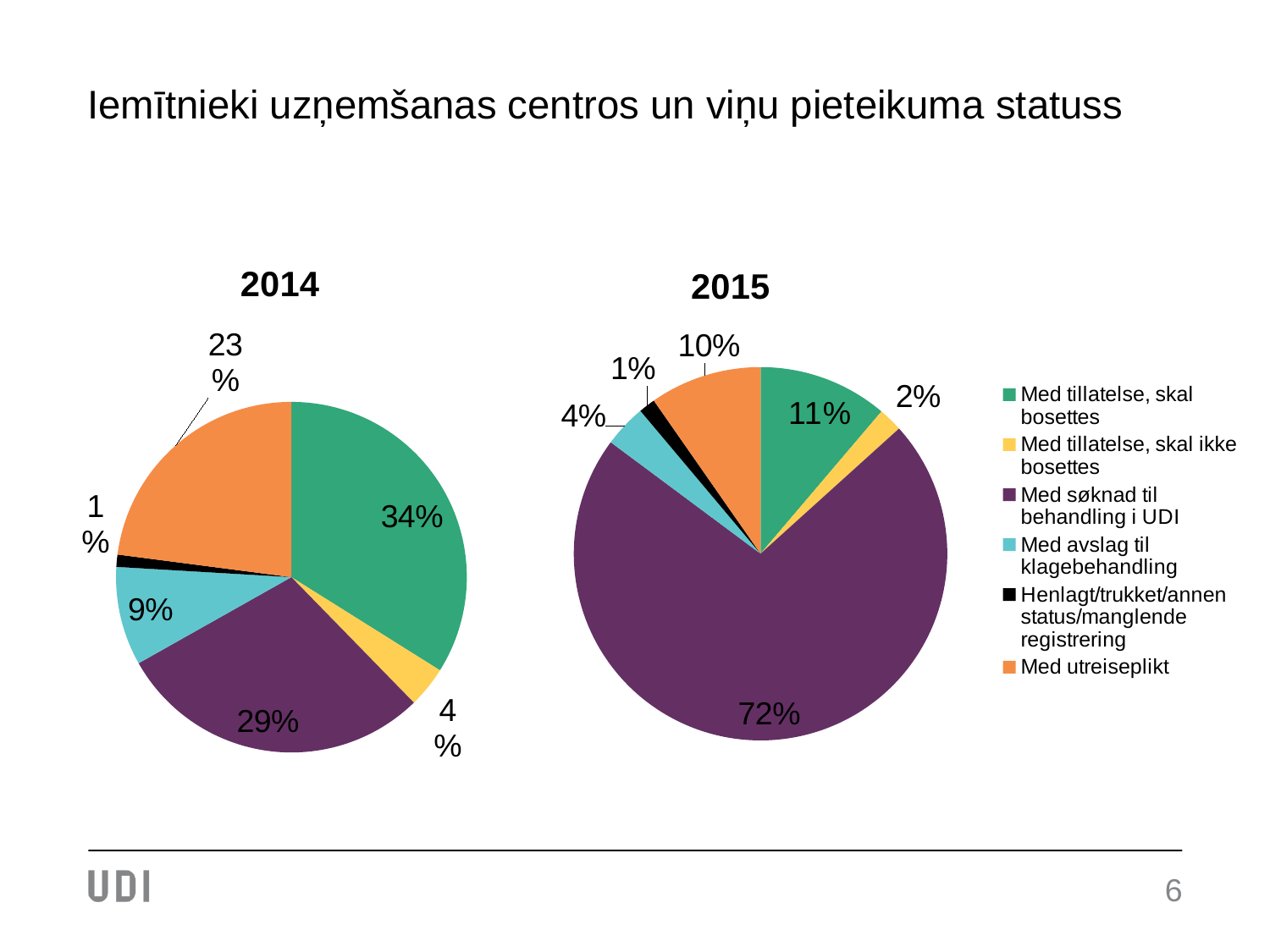
In the 2014 pie chart, which category has the smallest slice? Henlagt/trukket/annen status/manglende registrering In the 2014 pie chart, which category has the largest slice? Med tillatelse, skal bosettes In the 2015 pie chart, what share is labelled for 'Med søknad til behandling i UDI'? 72% What is the difference between the 'Med søknad til behandling i UDI' share in 2015 and in 2014? 43 percentage points In the 2014 pie chart, what share is labelled for 'Med utreiseplikt'? 23% In the 2014 pie chart, which is larger: the share for 'Med avslag til klagebehandling' or for 'Med tillatelse, skal ikke bosettes'? Med avslag til klagebehandling What type of chart is used for the 2014 and 2015 data? Pie chart In the 2014 pie chart, what share is labelled for 'Med søknad til behandling i UDI'? 29% In the 2015 pie chart, which category has the largest slice? Med søknad til behandling i UDI In the 2015 pie chart, what share is labelled for 'Med tillatelse, skal bosettes'? 11% Which colour represents 'Med utreiseplikt' in the pie charts? Orange How many categories does the legend list? 6